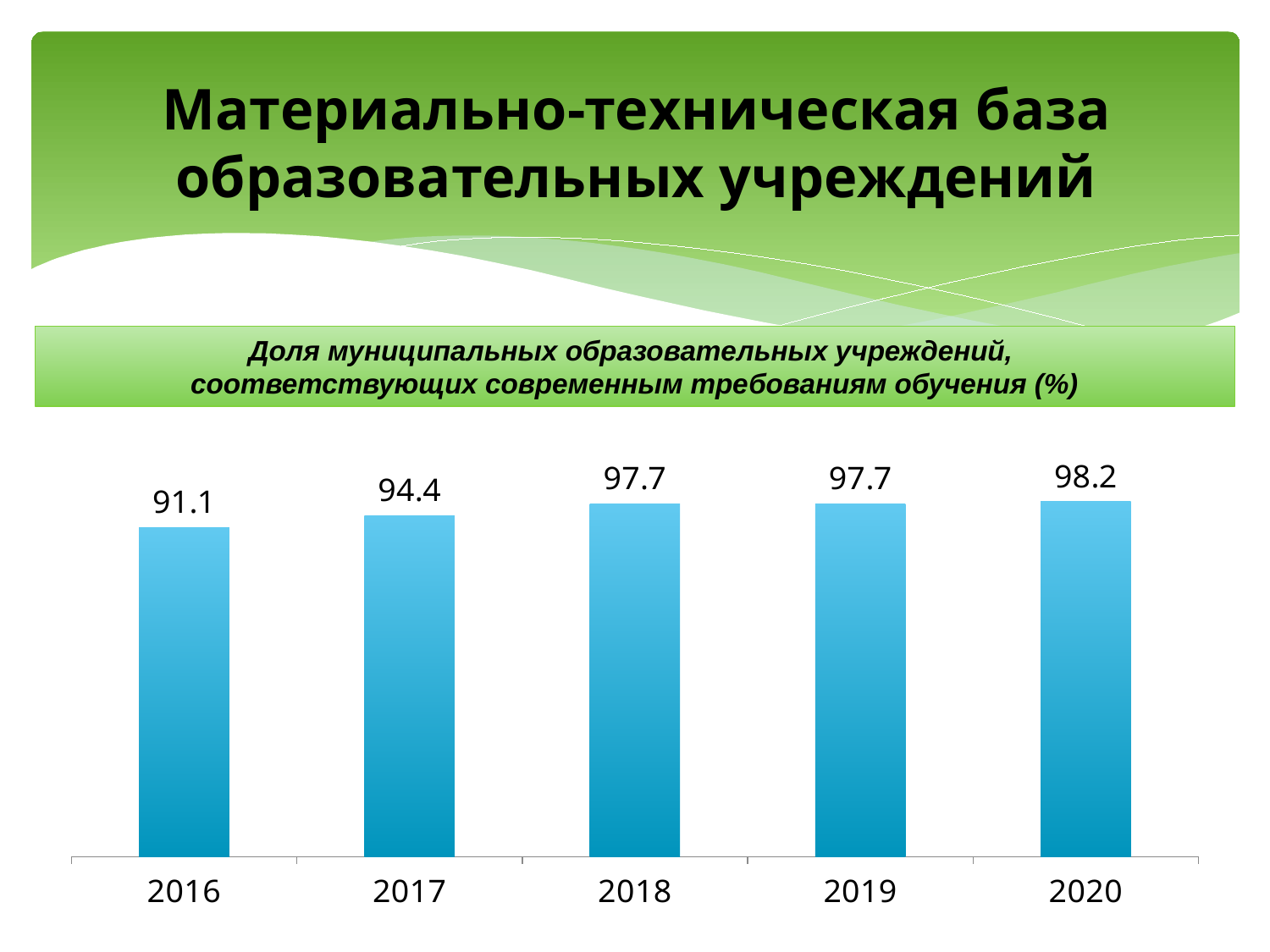
Which year has the highest value? 2020 Which is larger, the value for 2017 or the value for 2018? 2018 Which year has the lowest value? 2016 Do the values generally rise or fall from 2016 to 2020? rise What is the difference between the values for 2017 and 2016? 3.3 What kind of chart is shown on the slide? bar chart What is the value for 2017? 94.4 How many years are shown on the chart? 5 What is the value for 2020? 98.2 What is the difference between the values for 2020 and 2016? 7.1 Which two years have the same value? 2018 and 2019 What is the value for 2016? 91.1